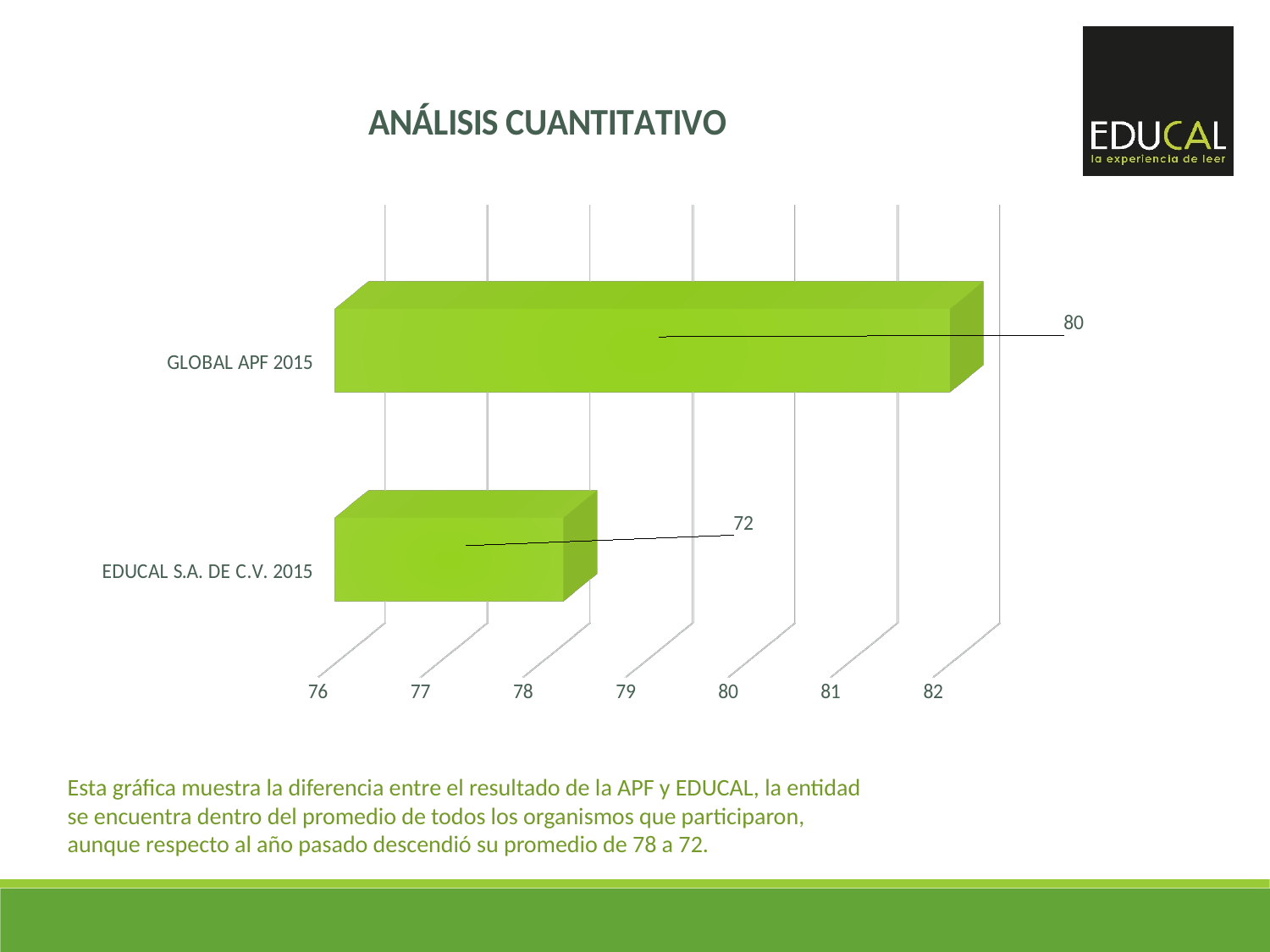
What colour are the bars in the chart? Green What is the difference between the values for GLOBAL APF 2015 and EDUCAL S.A. DE C.V. 2015? 8 What is the value for EDUCAL S.A. DE C.V. 2015? 72 What is the title of the slide containing the chart? ANÁLISIS CUANTITATIVO What kind of chart is shown on the slide? Bar chart What is the value for GLOBAL APF 2015? 80 Which category has the highest value? GLOBAL APF 2015 Which is larger, the value for GLOBAL APF 2015 or the value for EDUCAL S.A. DE C.V. 2015? GLOBAL APF 2015 Which category has the lowest value? EDUCAL S.A. DE C.V. 2015 How many categories are shown in the chart? 2